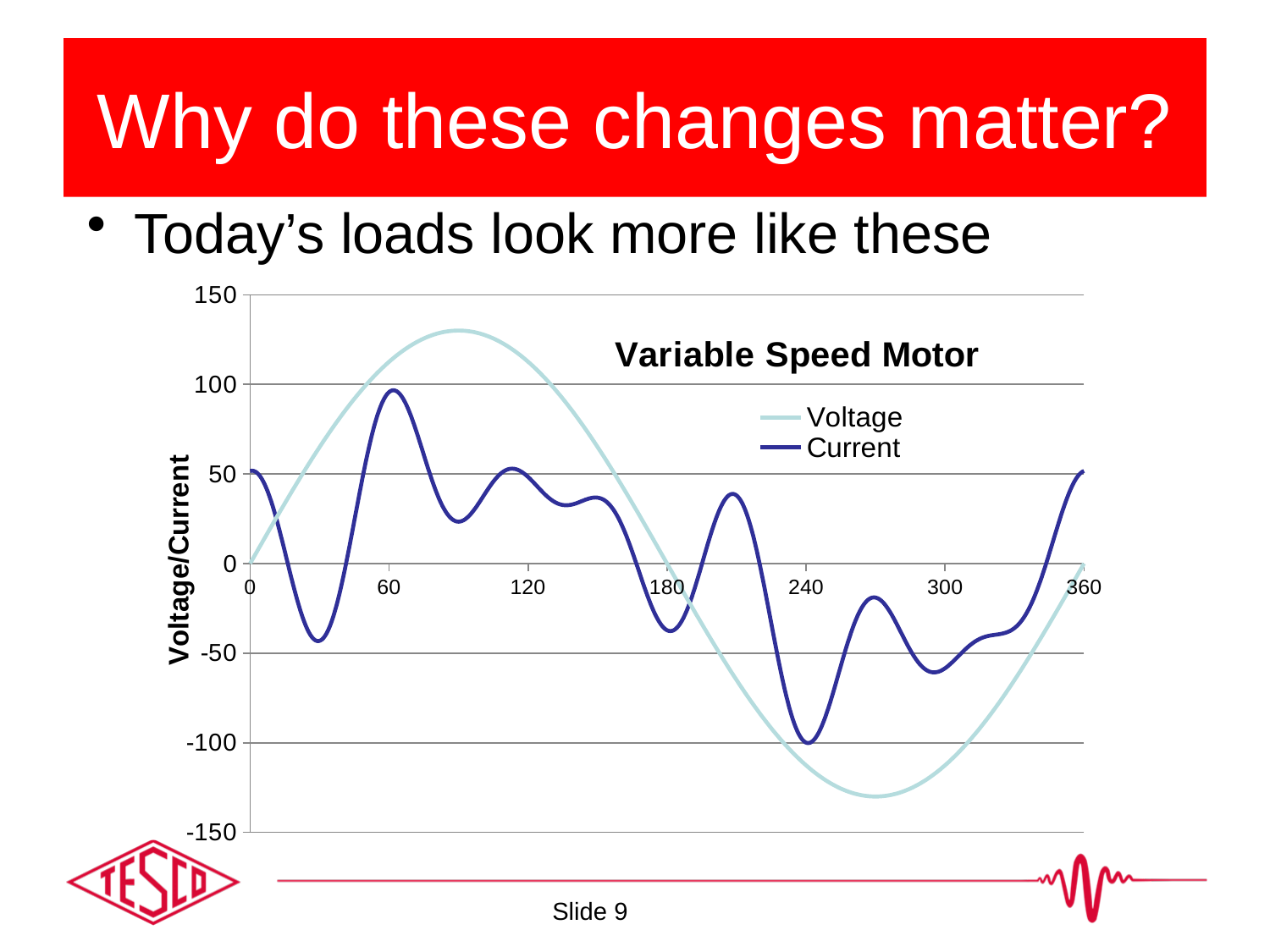
Is the value of the Current series at x = 30 greater or less than 0? less What is the title of the chart? Variable Speed Motor What kind of chart is shown on the slide? line chart Is the value of the Voltage series at x = 90 greater or less than 100? greater At x = 90, which series has the larger value, Voltage or Current? Voltage Does the Voltage series rise or fall between x = 90 and x = 270? fall How many series does the chart's legend list? 2 Is the value of the Voltage series at x = 270 greater or less than -100? less What is the value of the Voltage series at x = 0? 0 What is the value of the Voltage series at x = 180? 0 What is the label on the vertical axis of the chart? Voltage/Current